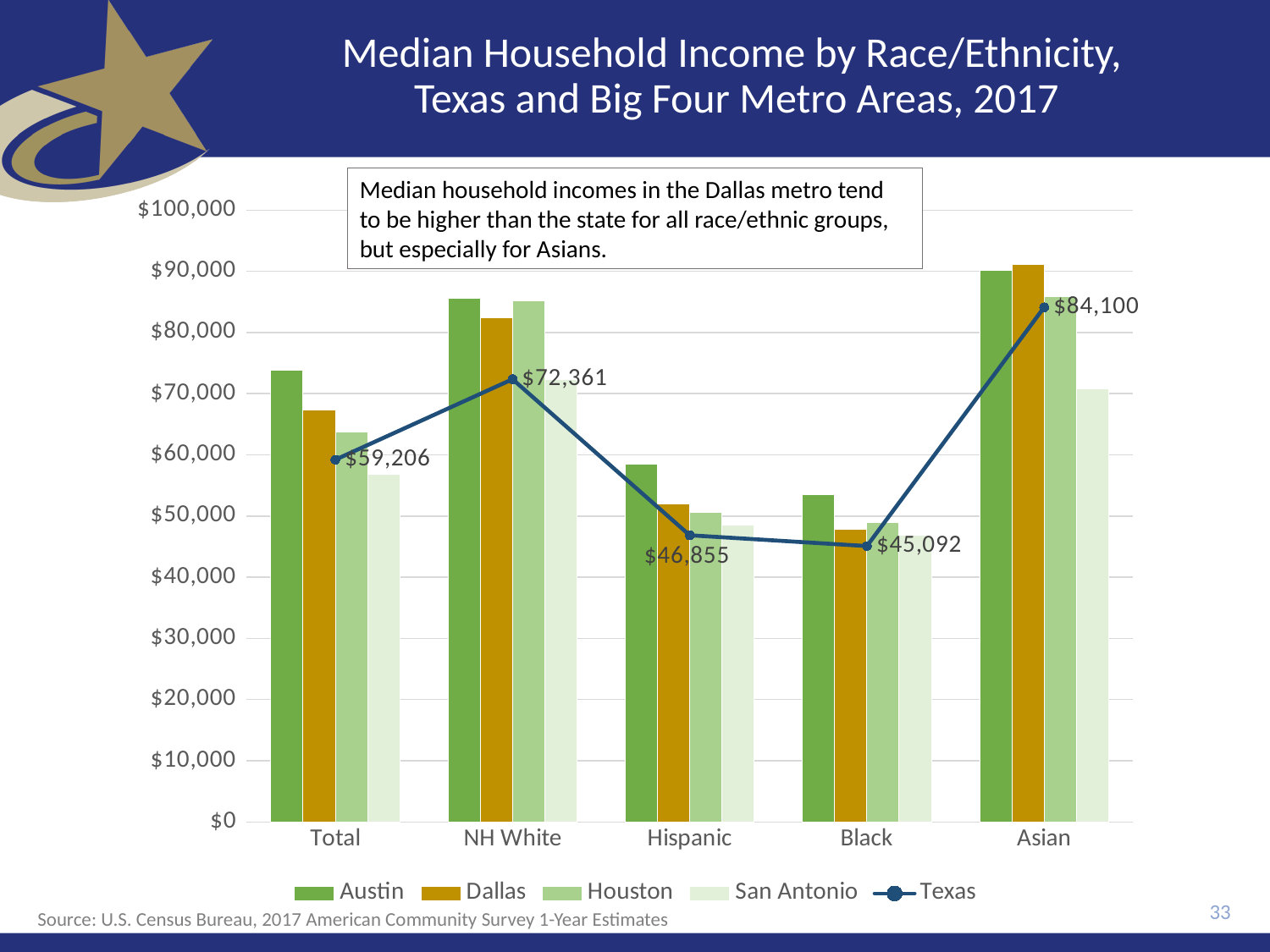
How many series does the legend list? 5 What is the Texas median household income for NH White households? $72,361 Is the San Antonio bar for the Total category greater or less than $60,000? less What is the Texas median household income for the Total category? $59,206 For which race/ethnicity group is the Texas median household income lowest? Black Which is larger for Texas: the median household income for Hispanic households or for Black households? Hispanic Is the Austin bar for the Total category greater or less than $70,000? greater What is the Texas median household income for Asian households? $84,100 For which race/ethnicity group is the Texas median household income highest? Asian How many race/ethnicity categories are shown on the x axis? 5 Which series is plotted as a line rather than bars? Texas What is the difference between the Texas median household income for Asian and Black households? $39,008